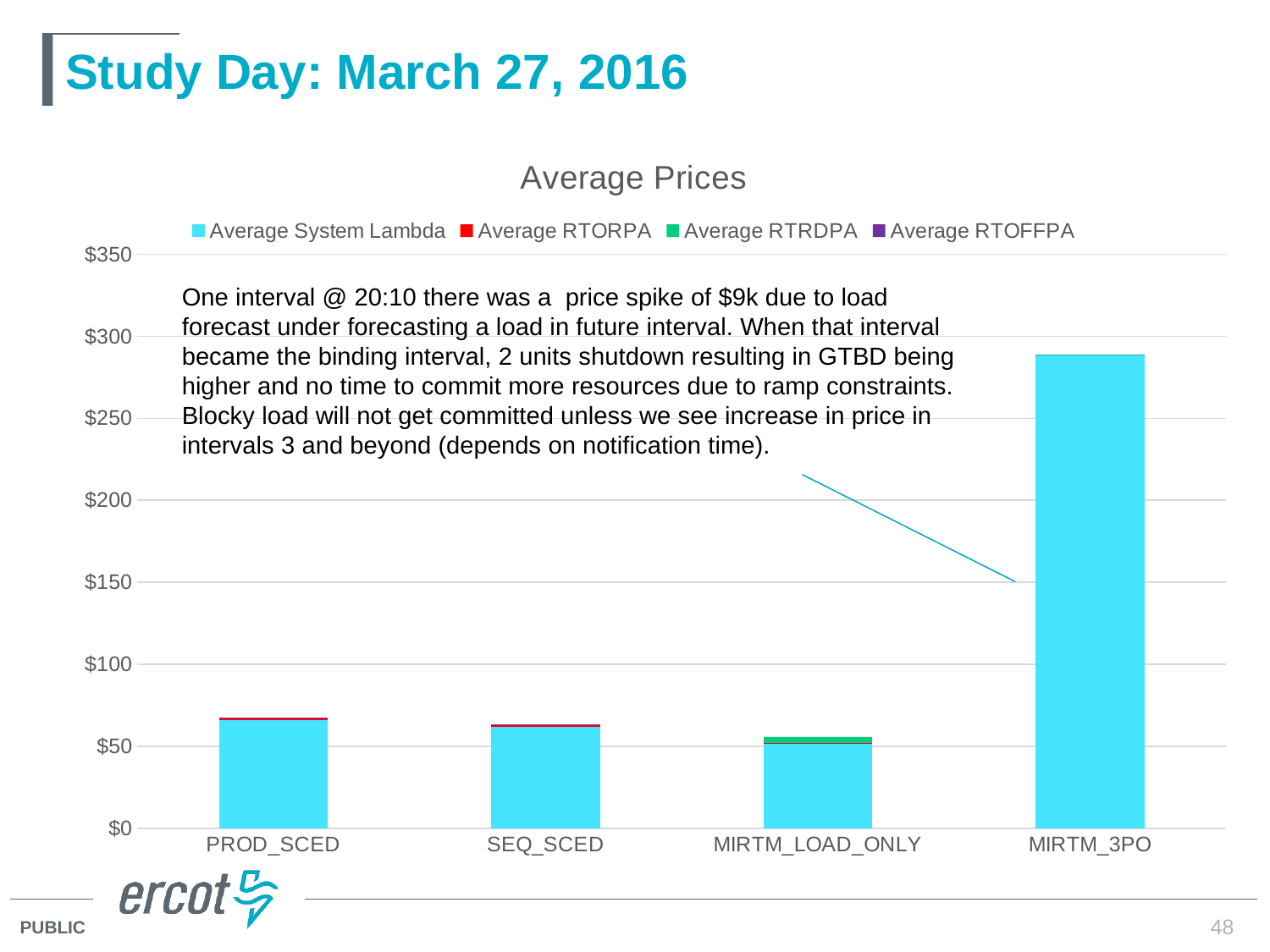
Is the total value for PROD_SCED greater or less than $50? greater Which has the larger total bar, MIRTM_3PO or SEQ_SCED? MIRTM_3PO Is the total value for MIRTM_3PO greater or less than $250? greater Which category has the lowest total bar? MIRTM_LOAD_ONLY Which series is shown in light blue in the legend? Average System Lambda What kind of chart is shown on the slide? Bar chart What is the title of the chart? Average Prices How many categories are shown on the x axis? 4 Which category has the highest total bar? MIRTM_3PO Is the total value for MIRTM_LOAD_ONLY greater or less than $100? less How many series does the legend list? 4